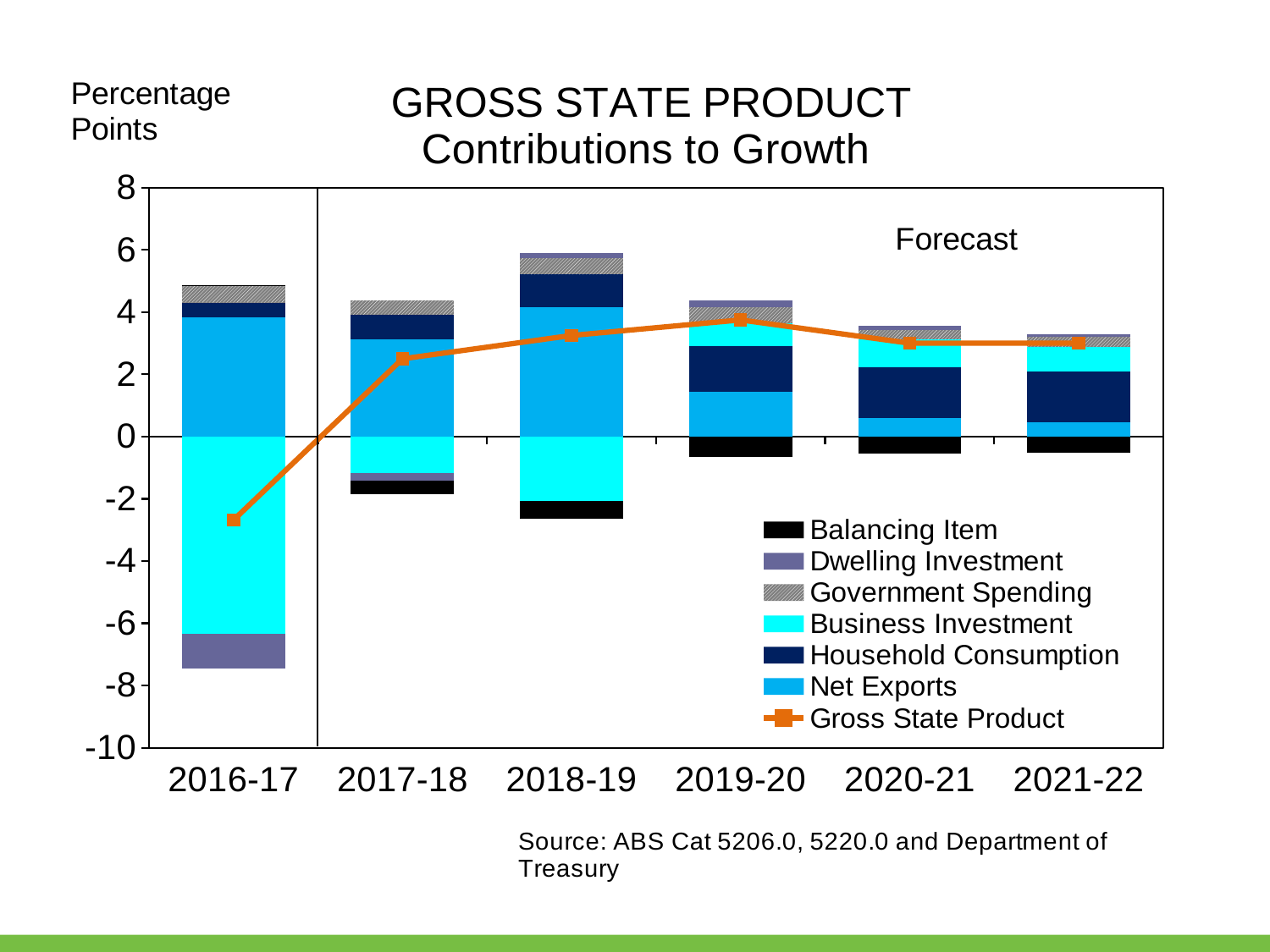
What is the title of the chart? GROSS STATE PRODUCT Contributions to Growth Is the Gross State Product value for 2016-17 greater or less than 0? less How many series does the legend list? 7 Which year has the larger Gross State Product value, 2016-17 or 2017-18? 2017-18 What kind of chart is shown on the slide? Stacked bar chart with a line Does the Gross State Product line rise or fall from 2016-17 to 2019-20? rise In which year is the Gross State Product line at its highest? 2019-20 Which series is plotted as a line rather than as bars? Gross State Product In which year is the Gross State Product line at its lowest? 2016-17 Is the Business Investment contribution for 2016-17 greater or less than -4? less How many years are shown along the x axis? 6 Is the Gross State Product value for 2019-20 greater or less than 2? greater